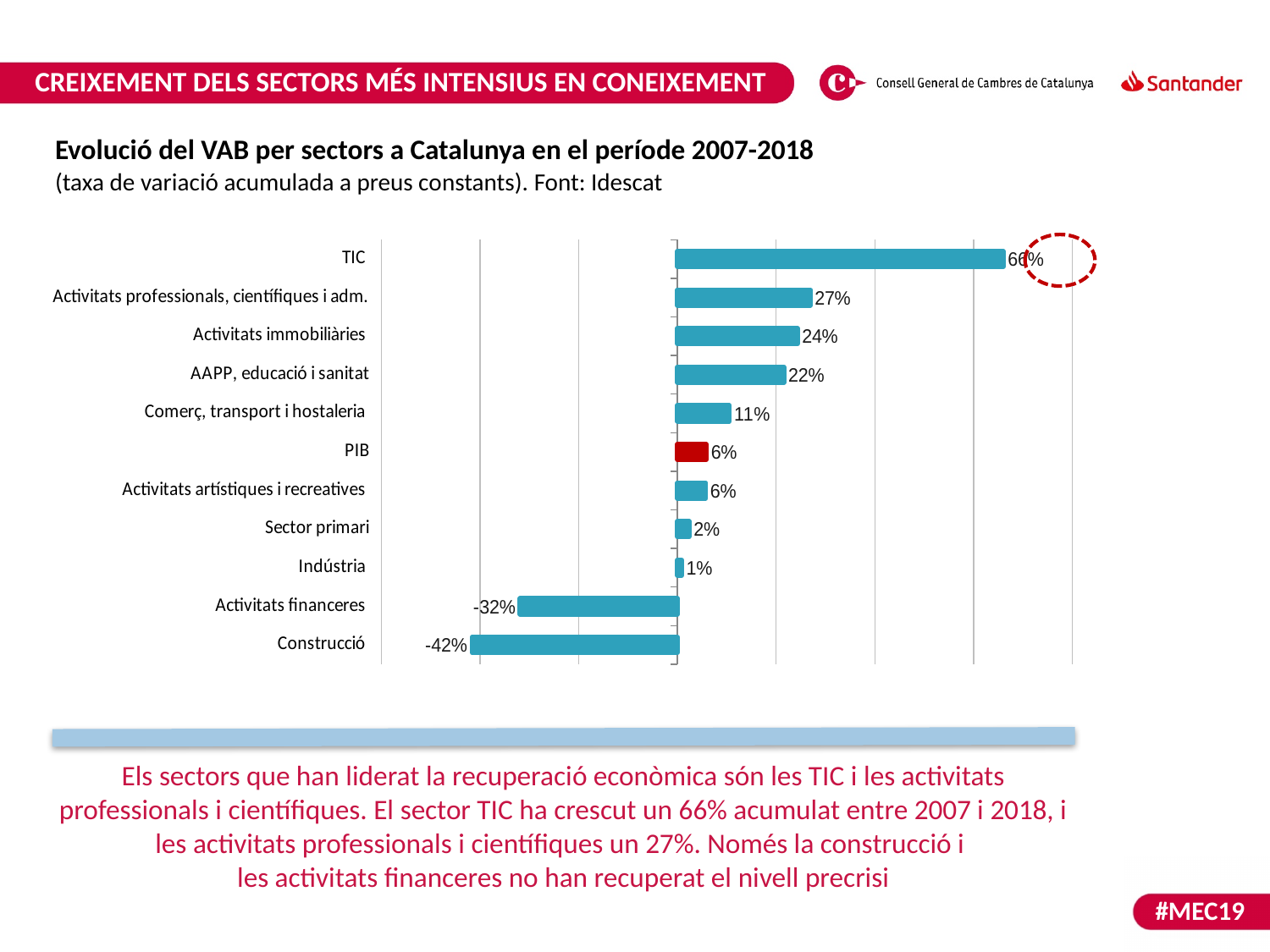
Which category has the highest value? TIC What is the value for Activitats professionals, científiques i adm.? 27% What is the difference between the values for TIC and Activitats professionals, científiques i adm.? 39% How many categories are shown in the chart? 11 Which category's bar is shown in red rather than blue? PIB Which is larger, the value for Activitats immobiliàries or the value for AAPP, educació i sanitat? Activitats immobiliàries What is the value for Construcció? -42% What is the difference between the values for Activitats financeres and Construcció? 10% What kind of chart is shown on the slide? Bar chart What is the value for PIB? 6% What is the value for TIC? 66% Which category has the lowest value? Construcció